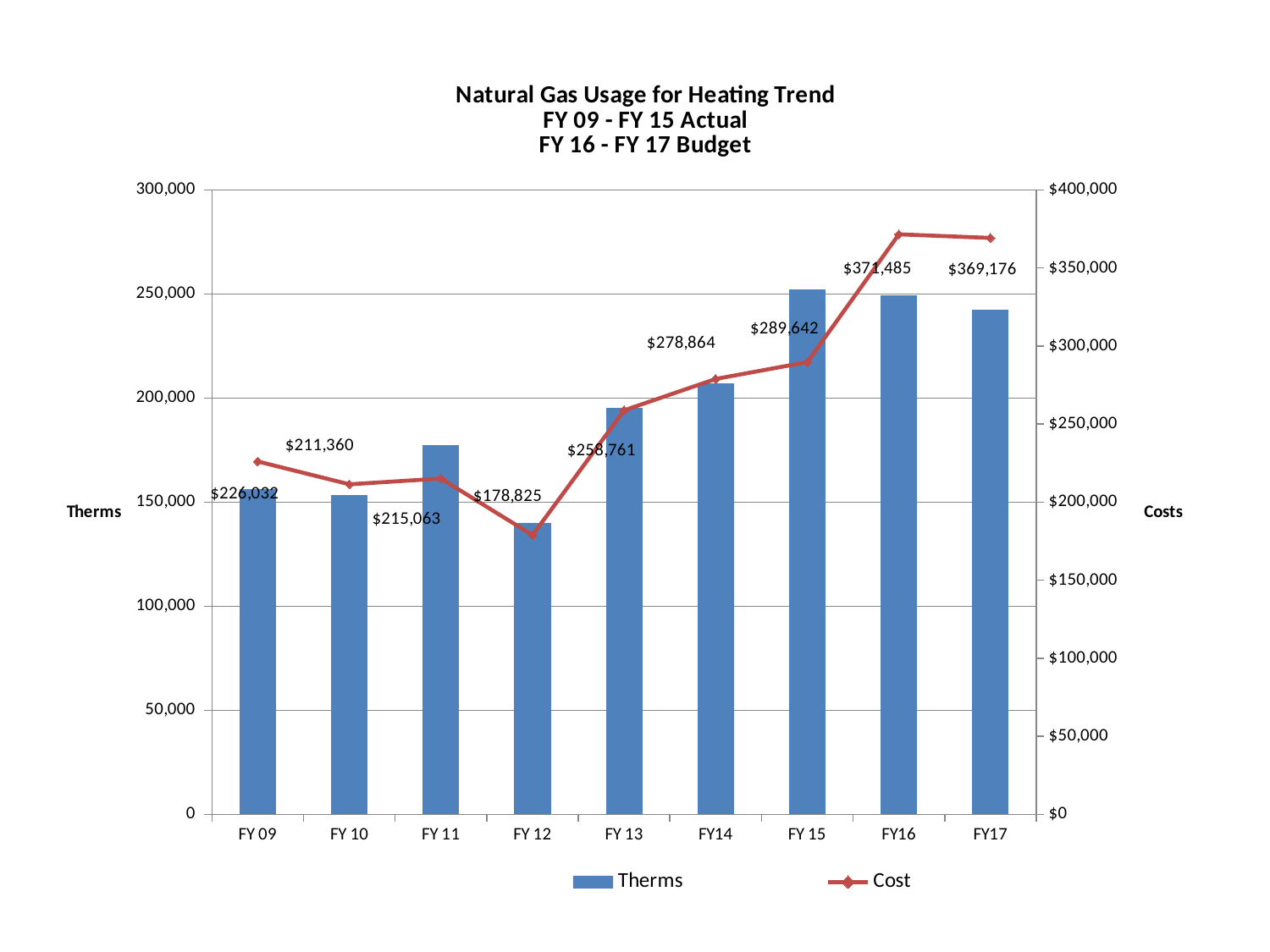
Which fiscal year has the highest Cost? FY16 What is the Cost value for FY 09? $226,032 Which is larger, the Cost for FY 13 or the Cost for FY14? FY14 How many fiscal years are shown on the x axis? 9 Does the Cost line rise or fall from FY 12 to FY16? rise What is the difference between the Cost for FY16 and the Cost for FY17? $2,309 What is the Cost value for FY16? $371,485 How many series does the legend list? 2 What is the Cost value for FY 12? $178,825 Is the Therms value for FY 12 greater or less than 150,000? less Which fiscal year has the lowest Cost? FY 12 Is the Therms value for FY16 greater or less than 200,000? greater